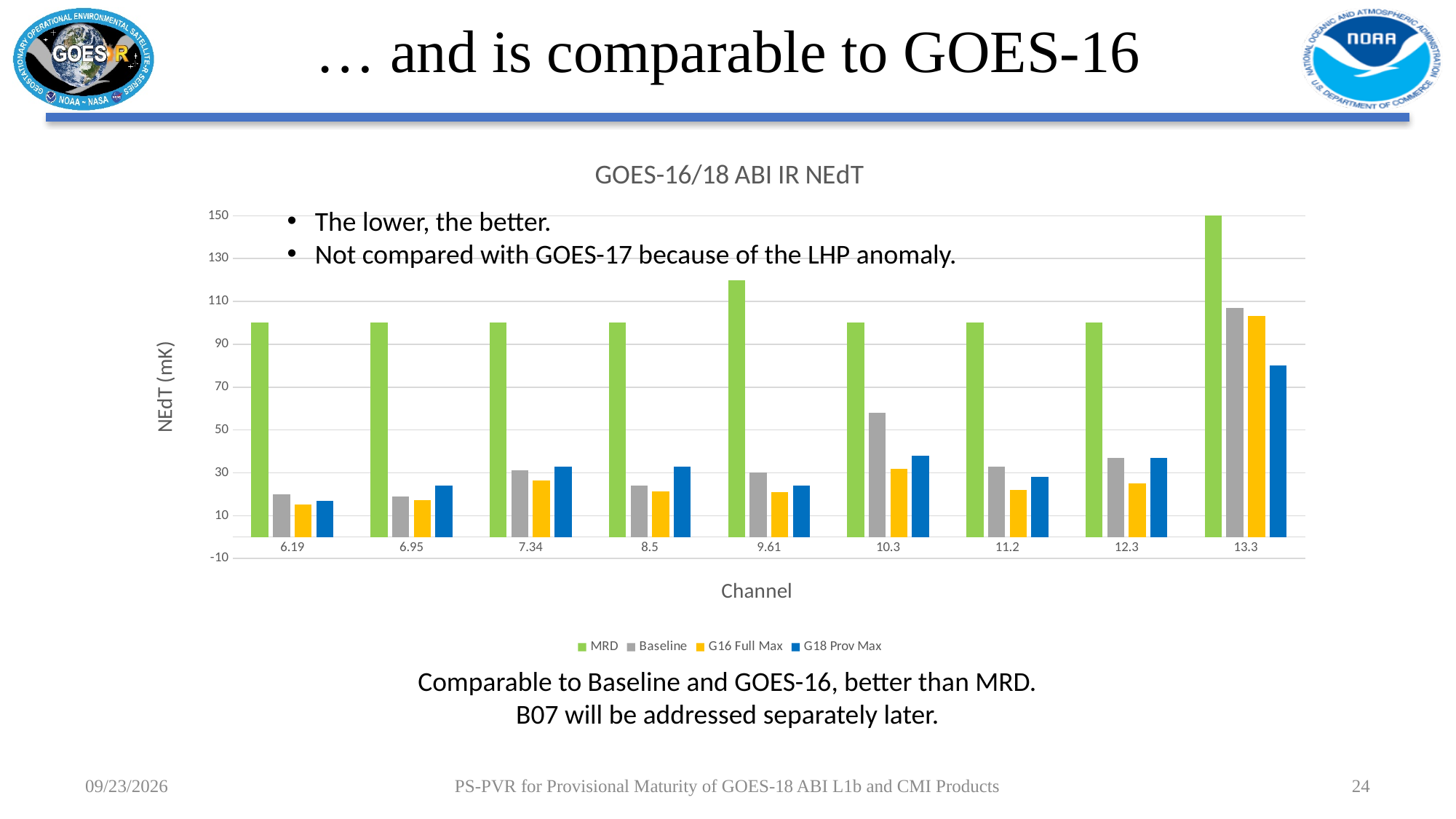
For which channel is the MRD value highest? 13.3 Is the G16 Full Max value for channel 6.19 greater or less than 30? less What type of chart is shown on the slide? bar chart For channel 13.3, which is larger: G16 Full Max or G18 Prov Max? G16 Full Max How many channels are shown along the x axis of the chart? 9 How many series does the chart legend list? 4 For channel 10.3, which is larger: Baseline or G18 Prov Max? Baseline What is the label of the y axis? NEdT (mK) What is the title of the chart? GOES-16/18 ABI IR NEdT Is the Baseline value for channel 13.3 greater or less than 90? greater For which channel is the G18 Prov Max value lowest? 6.19 Is the MRD value for channel 9.61 greater or less than 110? greater